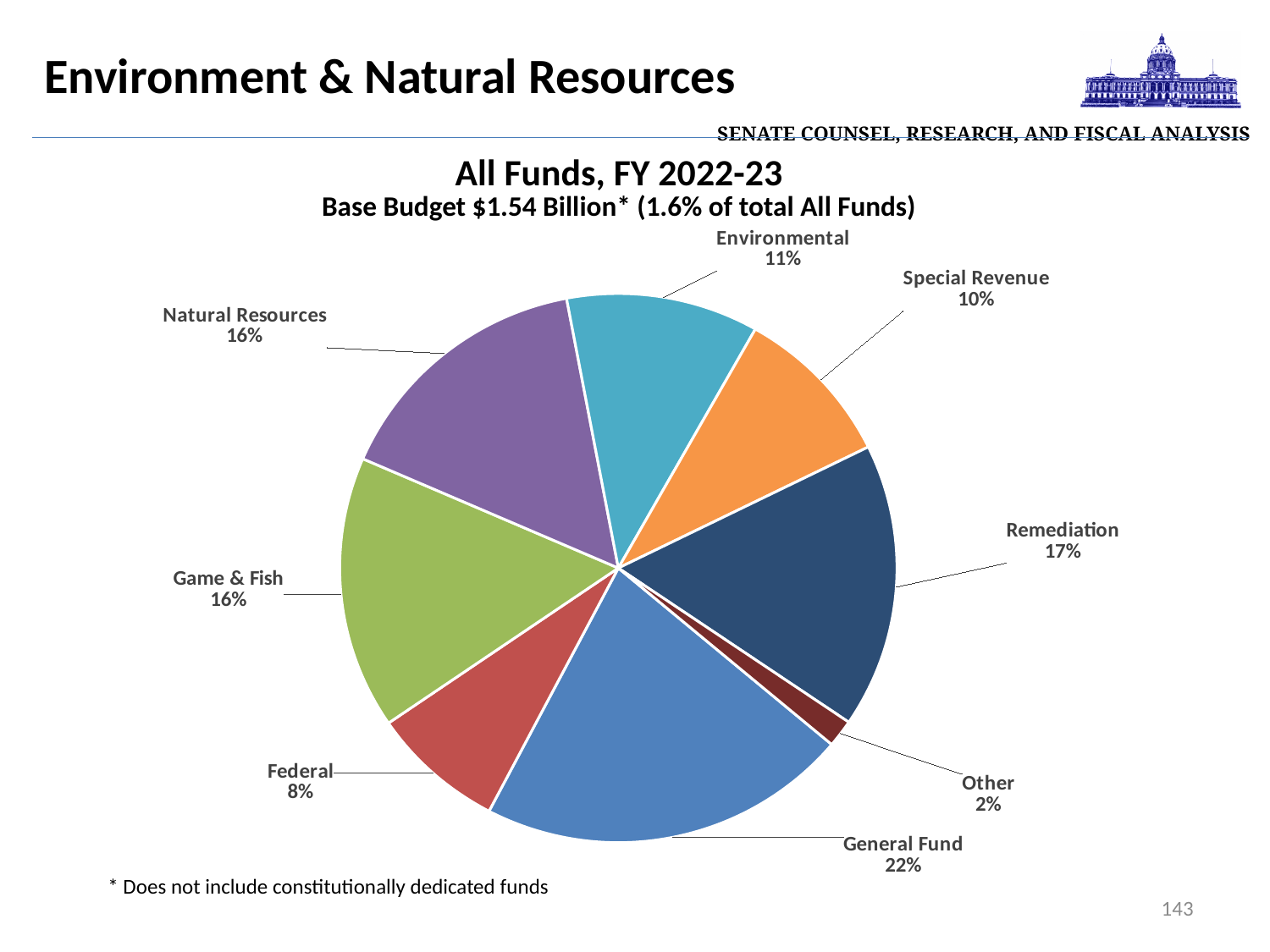
What kind of chart is shown on the slide? pie chart What is the difference between the General Fund share and the Federal share? 14% What base budget amount is stated in the chart subtitle? $1.54 Billion Which category has the largest share of the pie? General Fund What share of the pie does Remediation represent? 17% Which category has the smallest share of the pie? Other What is the value shown for Federal? 8% How many categories are shown in the pie chart? 8 What is the title of the chart? All Funds, FY 2022-23 Which is larger, the Environmental share or the Special Revenue share? Environmental What share of the pie does General Fund represent? 22% What is the value shown for Special Revenue? 10%